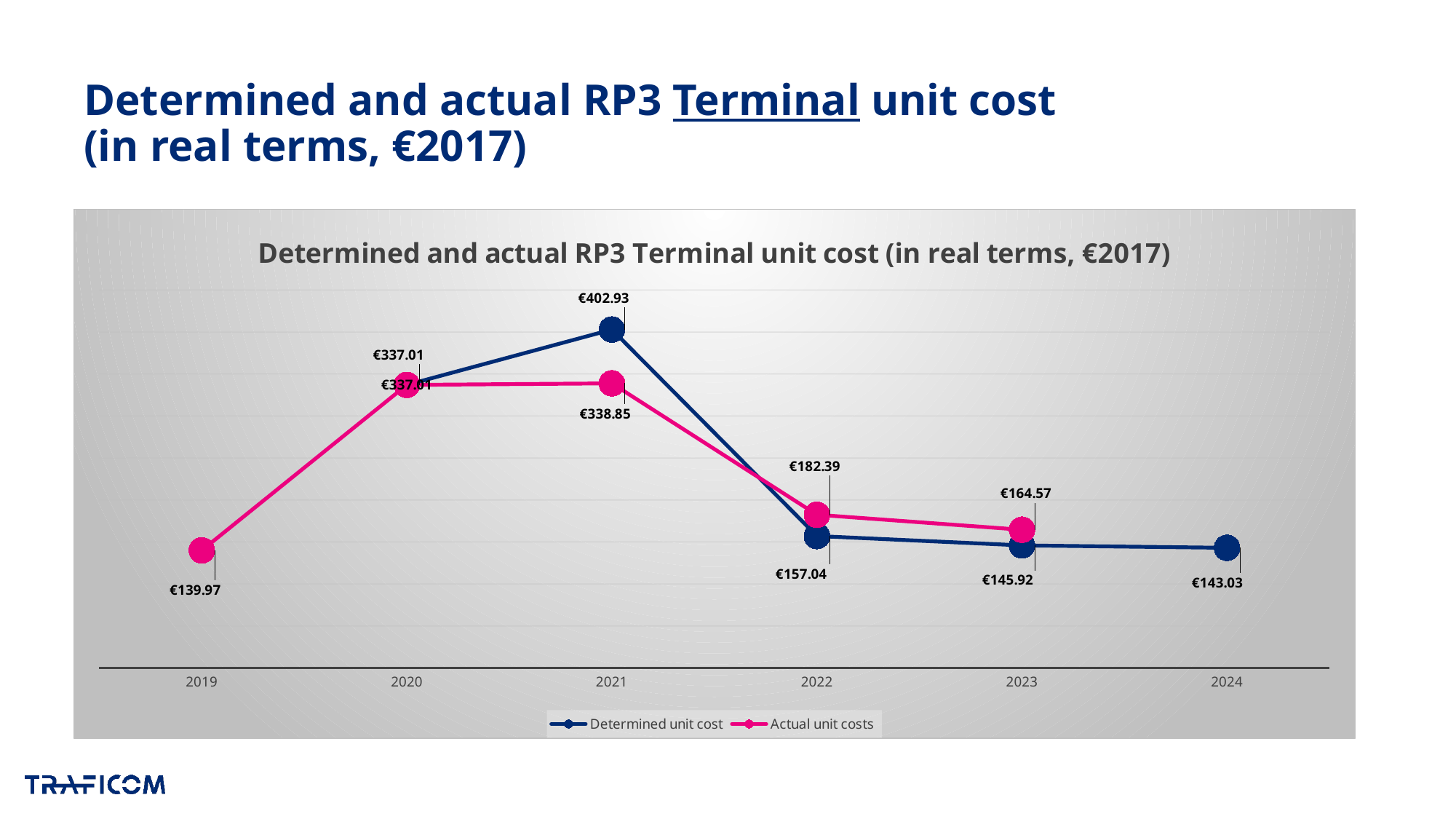
What is the difference between the Determined unit cost and the Actual unit cost in 2021? €64.08 What is the Actual unit cost for 2022? €182.39 What is the Determined unit cost for 2023? €145.92 What kind of chart is shown on the slide? Line chart How many years are shown on the x axis? 6 What is the Determined unit cost for 2024? €143.03 In 2022, which is larger: the Determined unit cost or the Actual unit cost? Actual unit cost In which year is the Determined unit cost highest? 2021 How many series does the legend list? 2 What is the Actual unit cost for 2021? €338.85 Does the Determined unit cost rise or fall from 2021 to 2024? Fall What is the Determined unit cost for 2021? €402.93